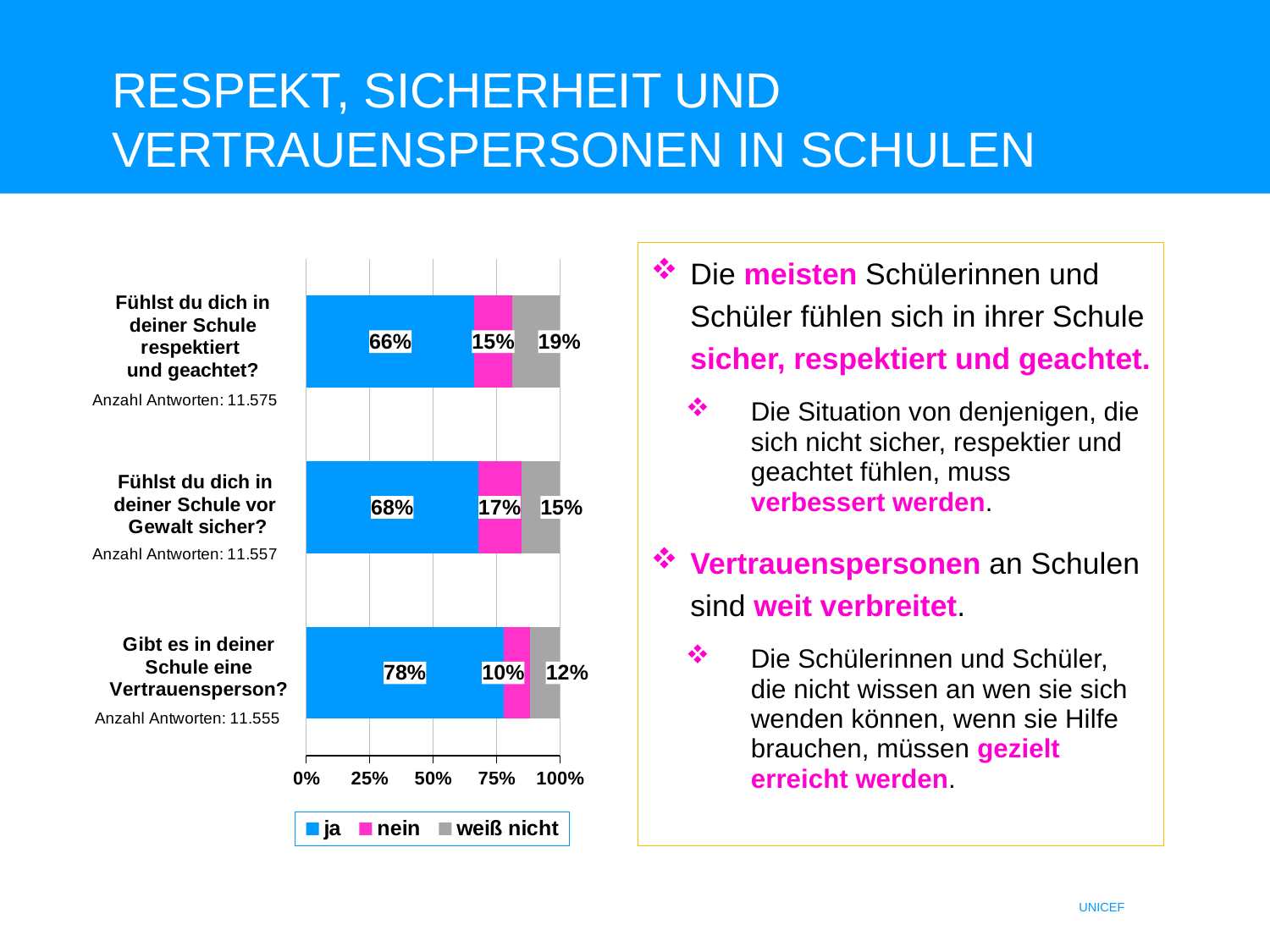
What are the three legend entries of the chart? ja, nein, weiß nicht Is the "ja" share for "Fühlst du dich in deiner Schule vor Gewalt sicher?" greater or less than 50%? greater How many questions (bars) are shown in the chart? 3 How many series does the legend list? 3 Which is larger: the "nein" share for "Fühlst du dich in deiner Schule vor Gewalt sicher?" or the "nein" share for "Fühlst du dich in deiner Schule respektiert und geachtet?"? Fühlst du dich in deiner Schule vor Gewalt sicher? What percentage answered "ja" to "Fühlst du dich in deiner Schule respektiert und geachtet?"? 66% What percentage answered "nein" to "Fühlst du dich in deiner Schule vor Gewalt sicher?"? 17% What percentage answered "weiß nicht" to "Gibt es in deiner Schule eine Vertrauensperson?"? 12% Which question has the highest share of "ja" answers? Gibt es in deiner Schule eine Vertrauensperson? Which question has the lowest share of "weiß nicht" answers? Gibt es in deiner Schule eine Vertrauensperson? What kind of chart is shown on the slide? Stacked bar chart What is the difference between the "ja" share for "Gibt es in deiner Schule eine Vertrauensperson?" and the "ja" share for "Fühlst du dich in deiner Schule respektiert und geachtet?"? 12%